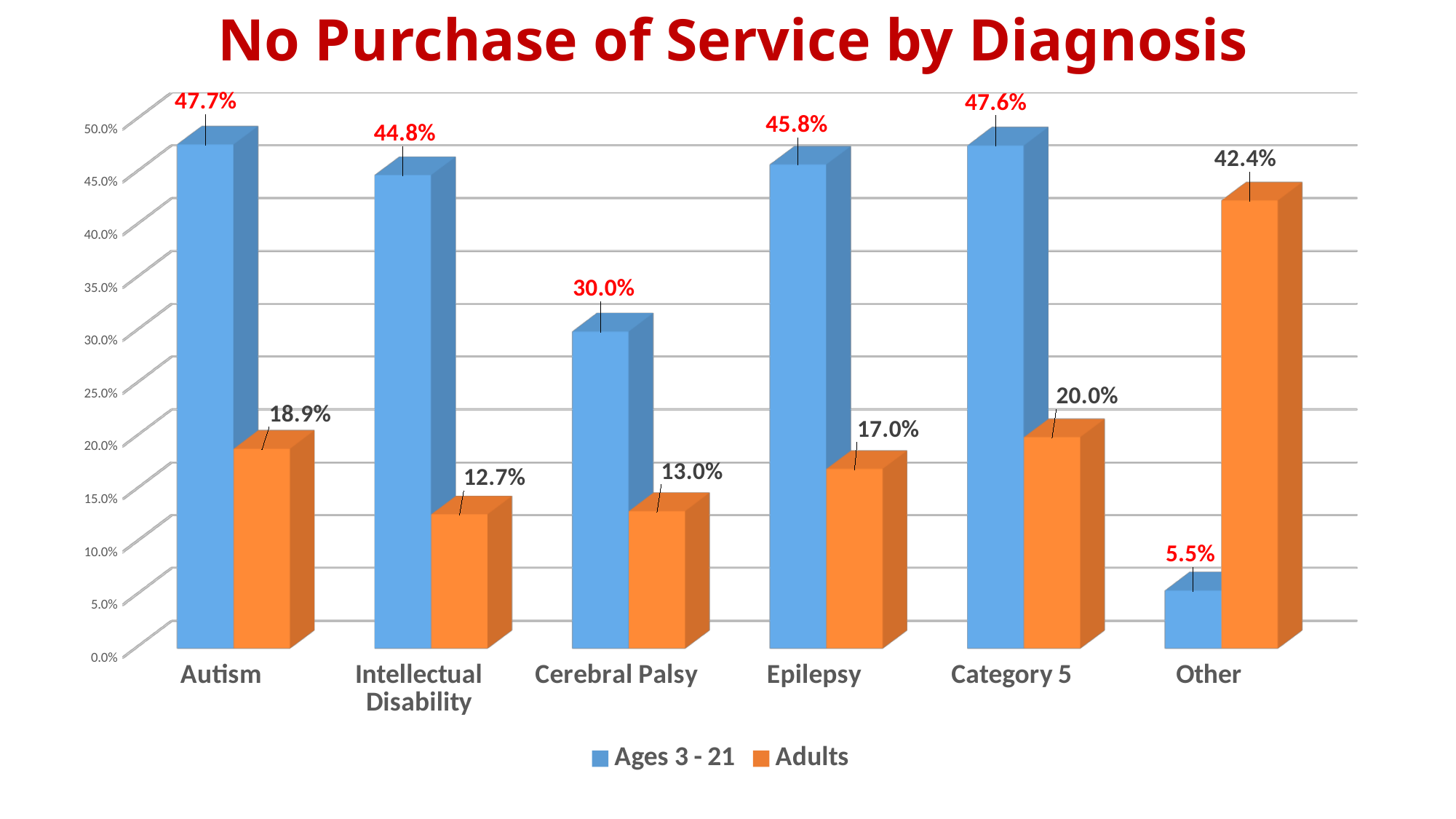
What is the value for Adults for Other? 42.4% What is the value for Adults for Intellectual Disability? 12.7% How many series does the legend list? 2 Which colour represents the Adults series? Orange Which is larger for Cerebral Palsy: the Ages 3 - 21 value or the Adults value? Ages 3 - 21 Which category has the highest value for Adults? Other What kind of chart is shown on the slide? Bar chart What is the value for Ages 3 - 21 for Autism? 47.7% What is the title of the chart? No Purchase of Service by Diagnosis How many diagnosis categories are shown on the x axis? 6 Which category has the lowest value for Ages 3 - 21? Other What is the difference between the Ages 3 - 21 and Adults values for Epilepsy? 28.8%